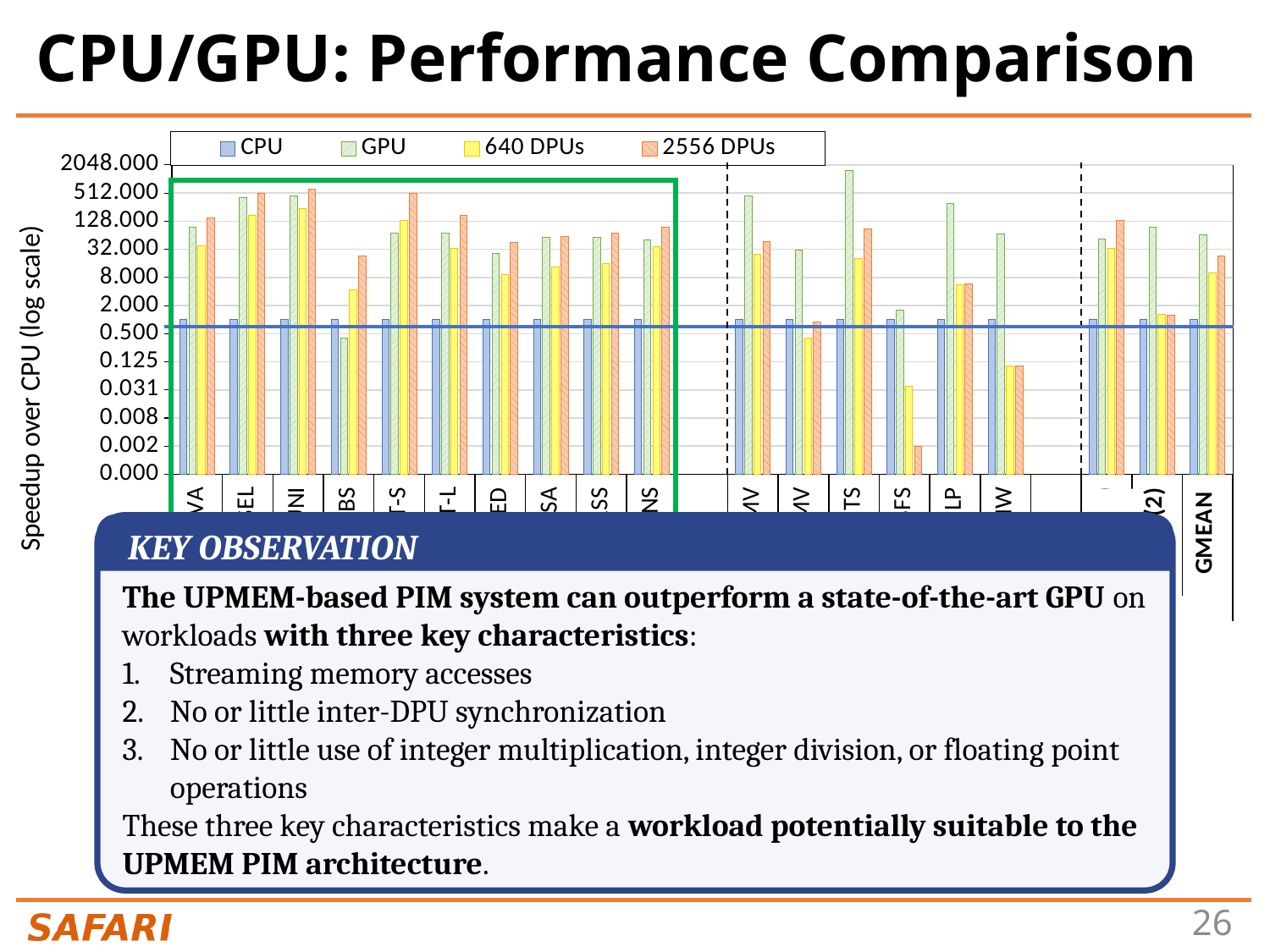
Is the 640 DPUs value for GMEAN greater or less than 32.000? less Is the GPU value for TS greater or less than 512.000? greater What is the label of the chart's vertical axis? Speedup over CPU (log scale) Is the GPU value for BS greater or less than 0.500? less For BS, which is larger: the GPU value or the 2556 DPUs value? 2556 DPUs Which series are listed in the chart's legend? CPU, GPU, 640 DPUs, 2556 DPUs For LP, which is larger: the GPU value or the 640 DPUs value? GPU For TS, which is larger: the GPU value or the 2556 DPUs value? GPU What kind of chart is shown on the slide? bar chart How many series does the chart's legend list? 4